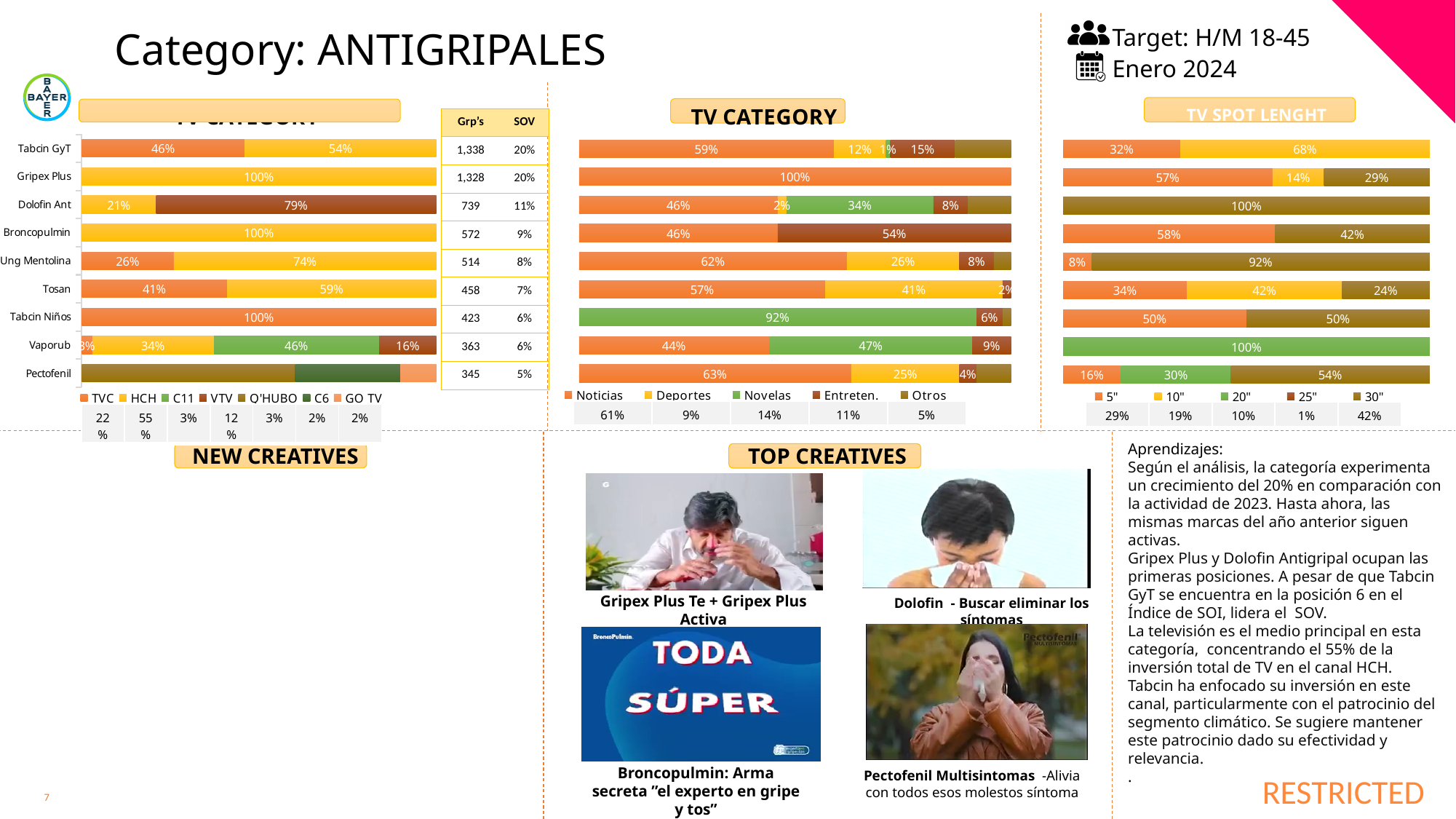
In the left TV CATEGORY chart (by channel), what share of Dolofin Ant's TV investment went to VTV? 79% In the middle TV CATEGORY chart (by genre), what share of Tabcin Niños' investment went to Novelas? 92% In the middle TV CATEGORY chart (by genre), what is the difference between Vaporub's Novelas share and its Noticias share? 3% In the right TV SPOT LENGHT chart, which brand has 100% of its spots at 20"? Vaporub In the left TV CATEGORY chart (by channel), how many brands are plotted? 9 In the right TV SPOT LENGHT chart, how many spot lengths does the legend list? 5 In the right TV SPOT LENGHT chart, what share of Ung Mentolina's spots are 30"? 92% In the middle TV CATEGORY chart (by genre), which brand has 100% of its investment in Noticias? Gripex Plus In the left TV CATEGORY chart (by channel), what share of Tabcin GyT's TV investment went to HCH? 54% In the left TV CATEGORY chart (by channel), how many series does the legend list? 7 In the middle TV CATEGORY chart (by genre), which is larger for Broncopulmin: Noticias or Entreten.? Entreten. What type of chart is the right TV SPOT LENGHT chart? Stacked bar chart